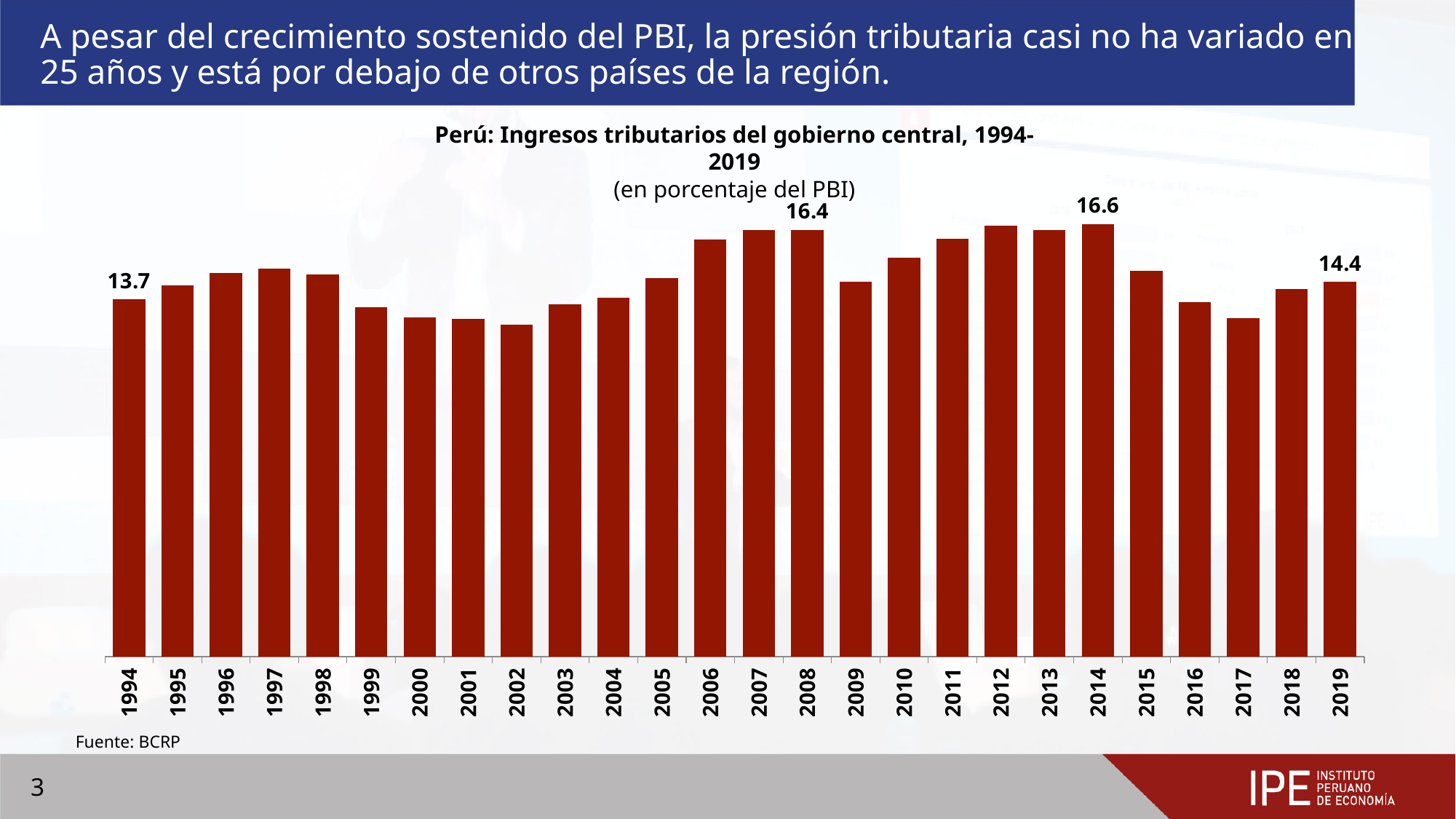
What kind of chart is shown on the slide? Bar chart What is the difference between the values for 2014 and 1994? 2.9 What is the value for 1994? 13.7 Which is larger, the value for 2014 or the value for 2019? 2014 What is the value for 2014? 16.6 What is the value for 2008? 16.4 What source is cited for the chart? BCRP How many years are shown on the x axis? 26 What is the difference between the values for 2019 and 1994? 0.7 What is the value for 2019? 14.4 Do the values rise or fall from 2014 to 2017? Fall What is the difference between the values for 2014 and 2019? 2.2